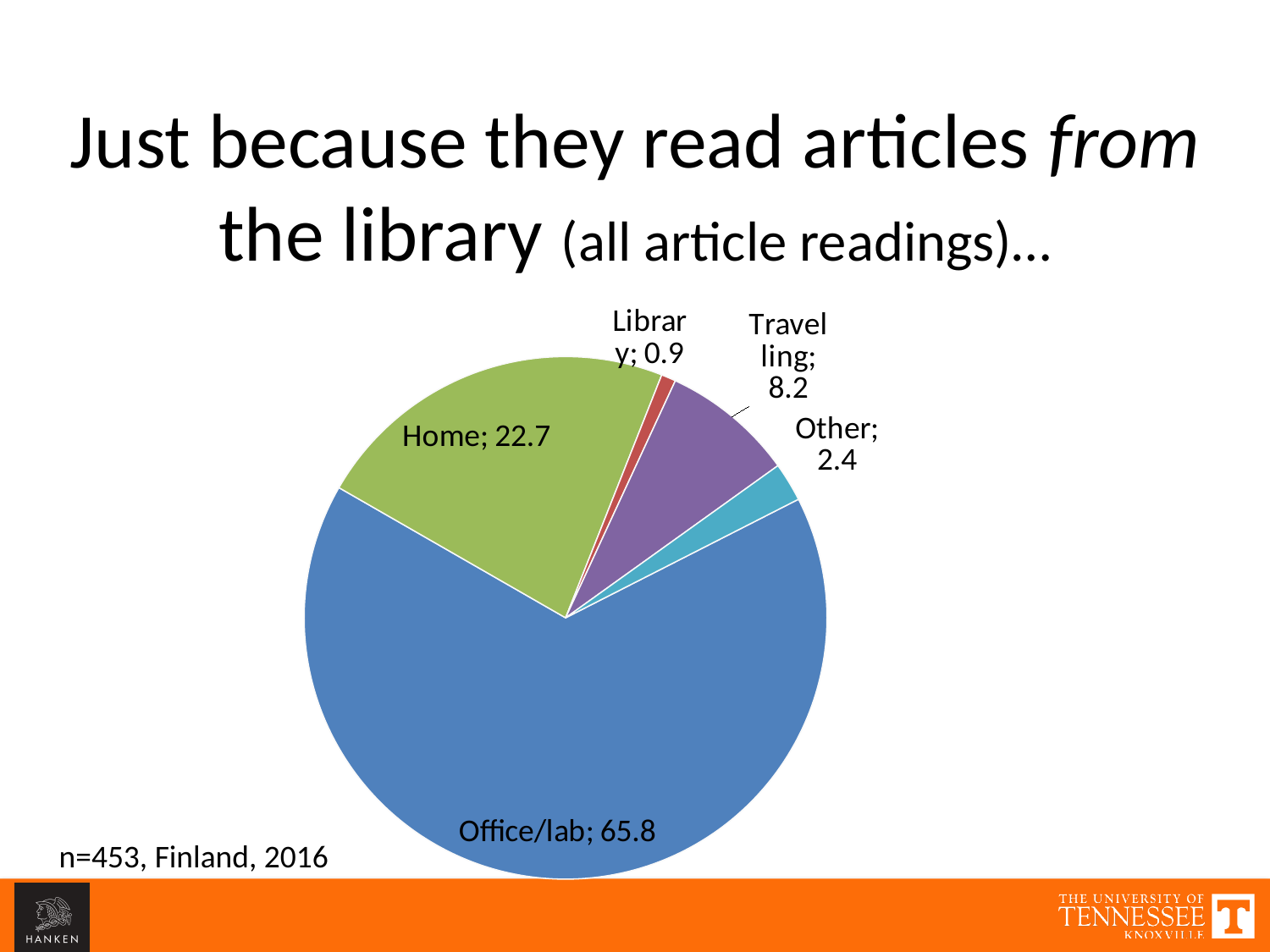
What is the value for Office/lab? 65.8 What is the value for Travelling? 8.2 Which is larger, the value for Travelling or the value for Other? Travelling What kind of chart is shown on the slide? Pie chart What is the value for Other? 2.4 How many slices does the pie chart have? 5 Which category has the largest slice of the pie? Office/lab What is the value for Home? 22.7 What sample size and country are noted below the chart? n=453, Finland, 2016 Which category has the smallest slice of the pie? Library What is the difference between the values for Office/lab and Home? 43.1 What is the value for Library? 0.9